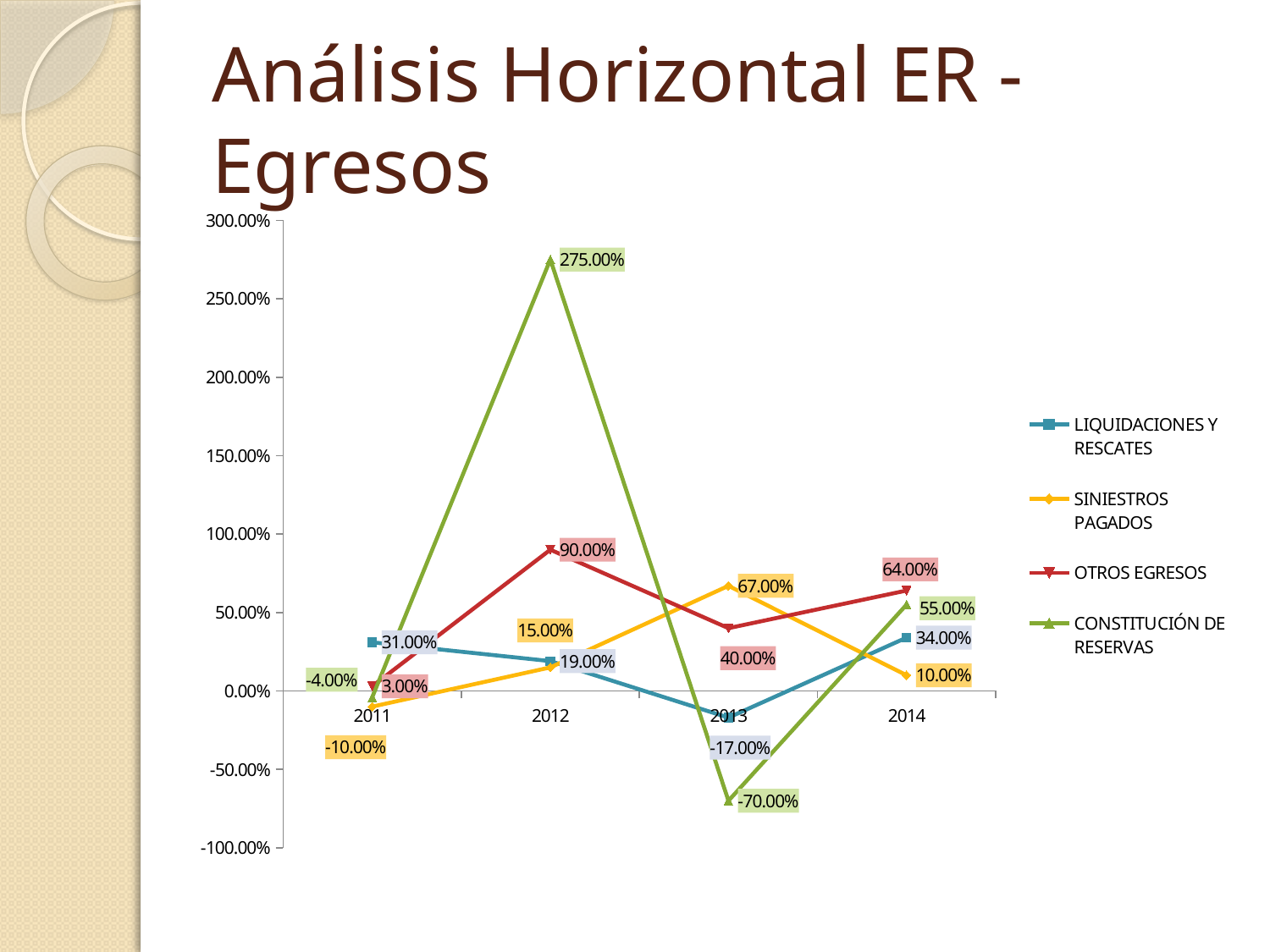
Which series has the lowest value in 2013? CONSTITUCIÓN DE RESERVAS What is the value for OTROS EGRESOS in 2013? 40.00% What is the value for LIQUIDACIONES Y RESCATES in 2014? 34.00% In which year does CONSTITUCIÓN DE RESERVAS reach its highest value? 2012 Which is larger in 2012, OTROS EGRESOS or LIQUIDACIONES Y RESCATES? OTROS EGRESOS What type of chart is shown on the slide? line chart What is the value for SINIESTROS PAGADOS in 2011? -10.00% Does the value for SINIESTROS PAGADOS rise or fall from 2013 to 2014? fall What is the value for CONSTITUCIÓN DE RESERVAS in 2012? 275.00% How many series does the legend list? 4 What is the difference between OTROS EGRESOS and SINIESTROS PAGADOS in 2014? 54.00% How many years are shown on the x axis? 4